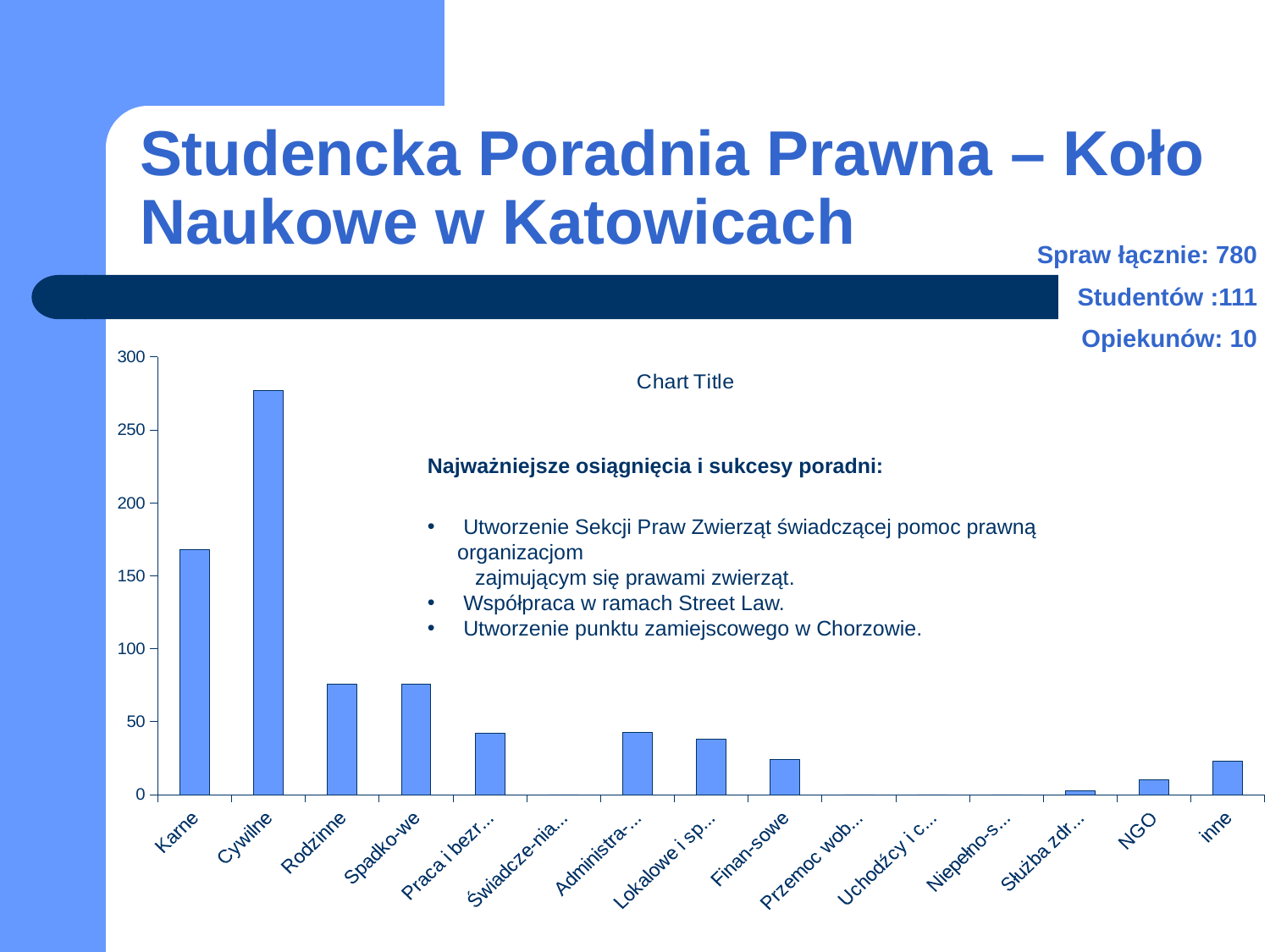
Is the value for Rodzinne greater or less than 50? greater Is the value for Finan-sowe greater or less than 50? less Is the value for Karne greater or less than 150? greater Which has a larger value, Karne or Cywilne? Cywilne Which has a larger value, Rodzinne or Karne? Karne Which category has the highest value in the chart? Cywilne What kind of chart is shown on the slide? bar chart How many categories are shown on the x axis of the chart? 15 What is the title shown on the chart? Chart Title